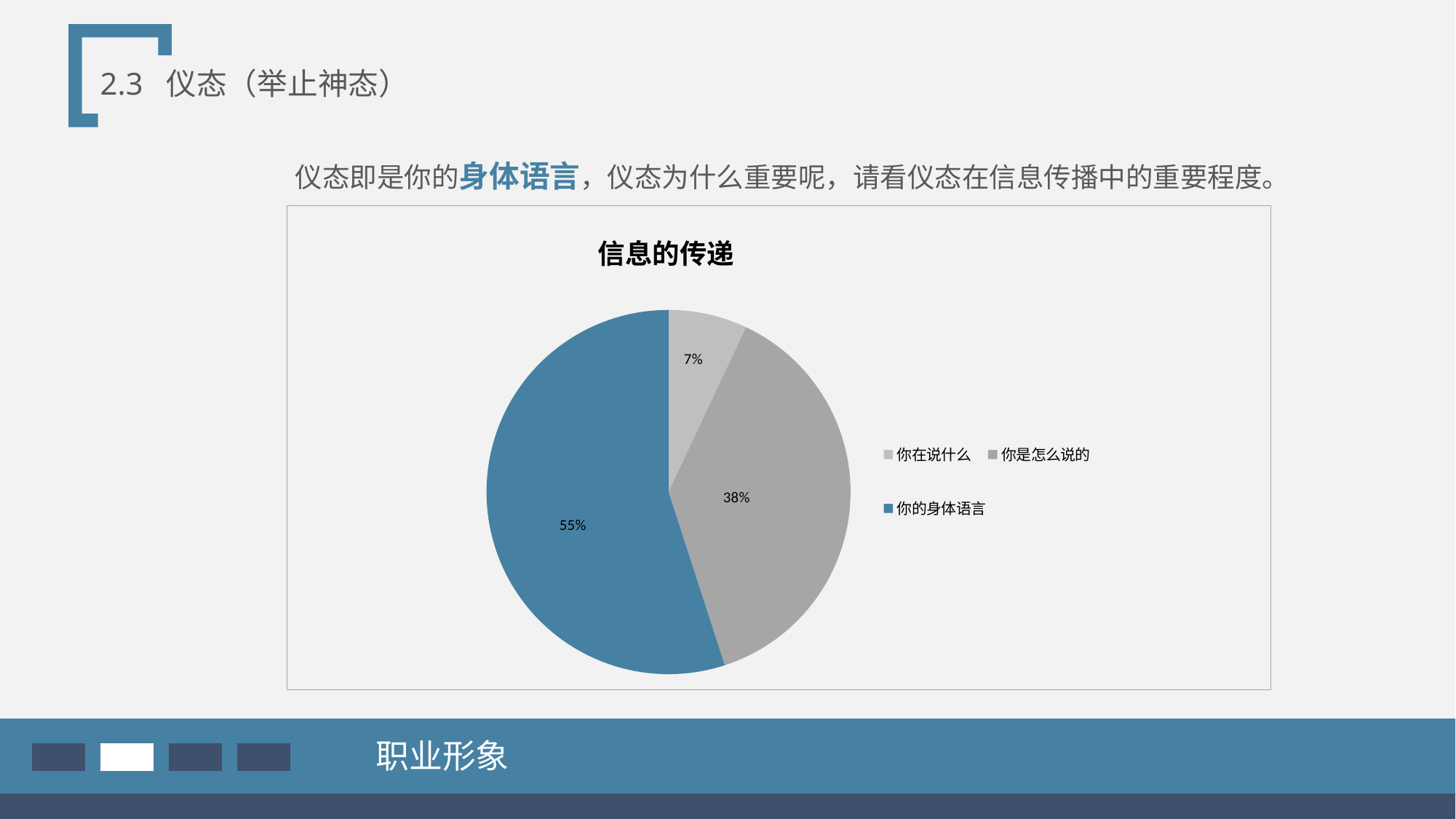
What is the title of the chart? 信息的传递 Which is larger, the share for 你是怎么说的 or the share for 你在说什么? 你是怎么说的 What percentage is shown for 你的身体语言? 55% Which category has the smallest share of the pie? 你在说什么 What percentage is shown for 你是怎么说的? 38% How many entries does the legend list? 3 What kind of chart is shown on the slide? pie chart Which category has the largest share of the pie? 你的身体语言 How many slices does the pie chart have? 3 What colour is the slice for 你的身体语言? blue What percentage is shown for 你在说什么? 7% What is the difference between the shares of 你的身体语言 and 你是怎么说的? 17%